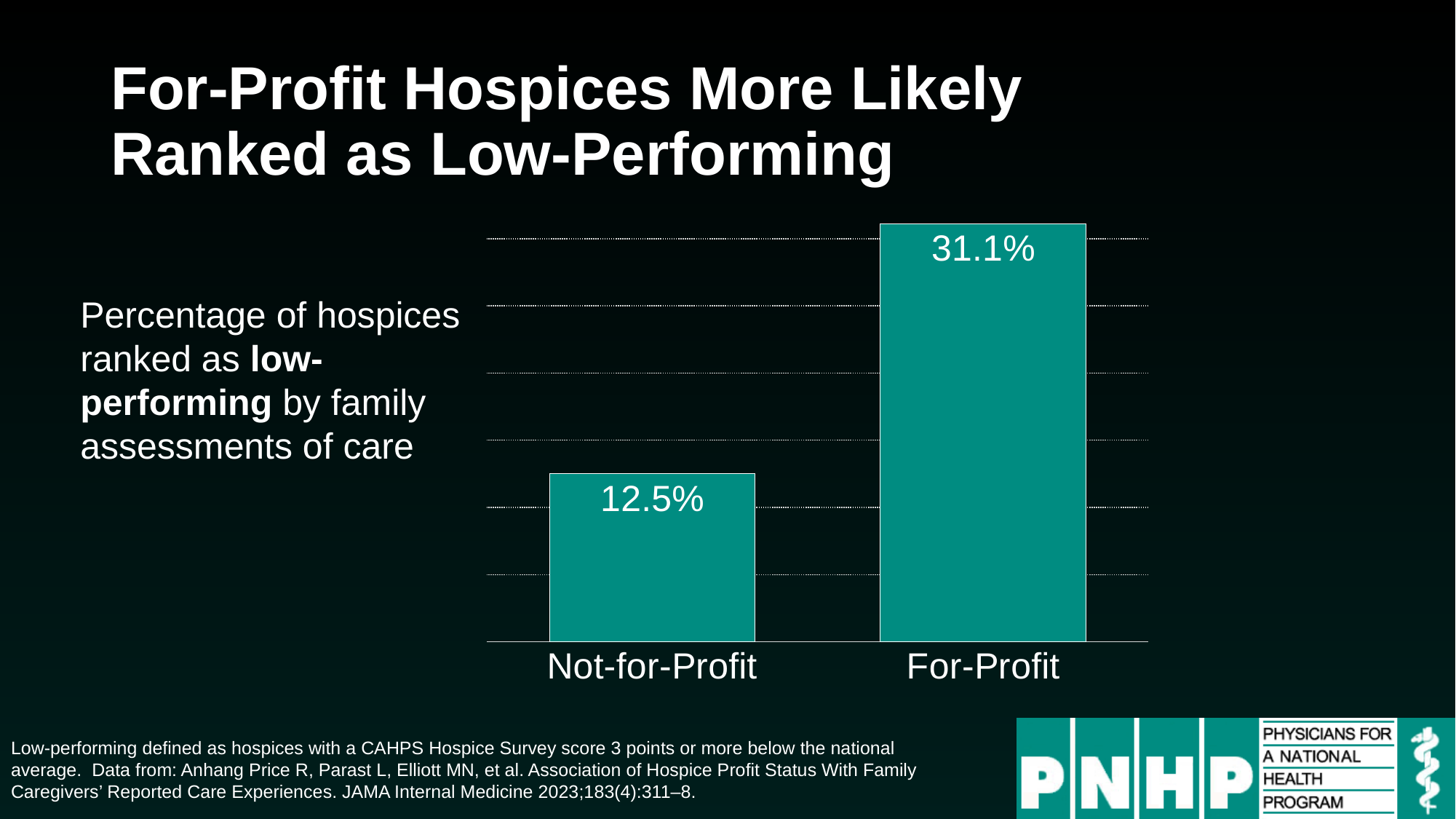
What percentage of Not-for-Profit hospices are ranked as low-performing? 12.5% What is the title of the slide containing the chart? For-Profit Hospices More Likely Ranked as Low-Performing What kind of chart is shown on the slide? bar chart Is the value for For-Profit larger or smaller than the value for Not-for-Profit? larger What colour are the bars in the chart? teal What percentage of For-Profit hospices are ranked as low-performing? 31.1% Which category has the lower percentage of hospices ranked as low-performing? Not-for-Profit Which category has the higher percentage of hospices ranked as low-performing? For-Profit How many categories are shown on the chart? 2 What is the difference in percentage points between the For-Profit and Not-for-Profit values? 18.6